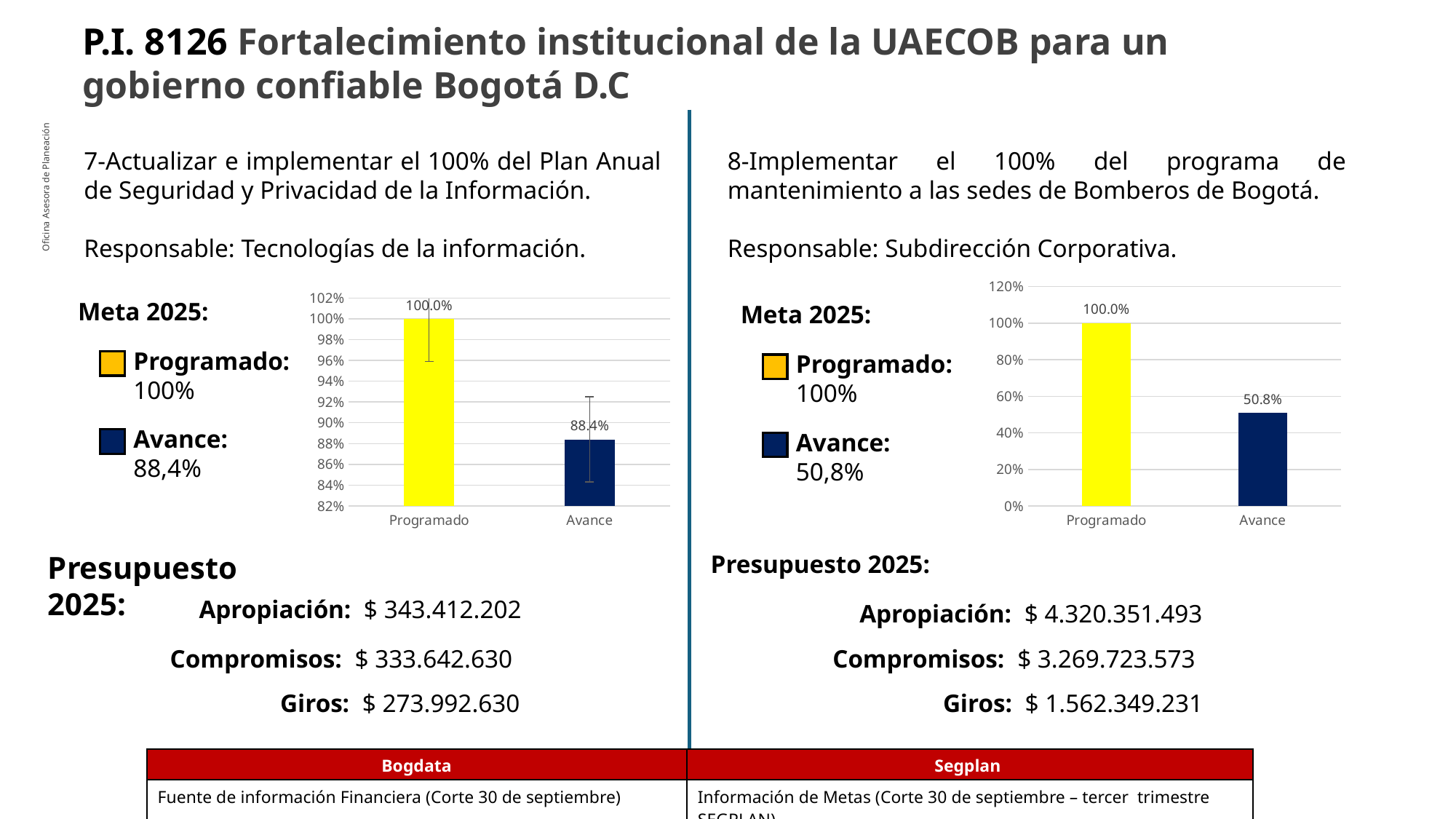
In the right chart, which category has the lowest value? Avance In the left chart, is the value for Avance greater or less than 86%? greater In the left chart, what is the difference between Programado and Avance? 11.6% In the left chart, which category has the highest value? Programado In the right chart, is the value for Avance greater or less than 60%? less In the left chart, what is the value for Programado? 100.0% What kind of chart is the left chart? bar chart In the left chart, what is the value for Avance? 88.4% In the right chart, what is the value for Avance? 50.8% How many categories are shown in the right chart? 2 In the right chart, what is the difference between Programado and Avance? 49.2% In the right chart, what is the value for Programado? 100.0%